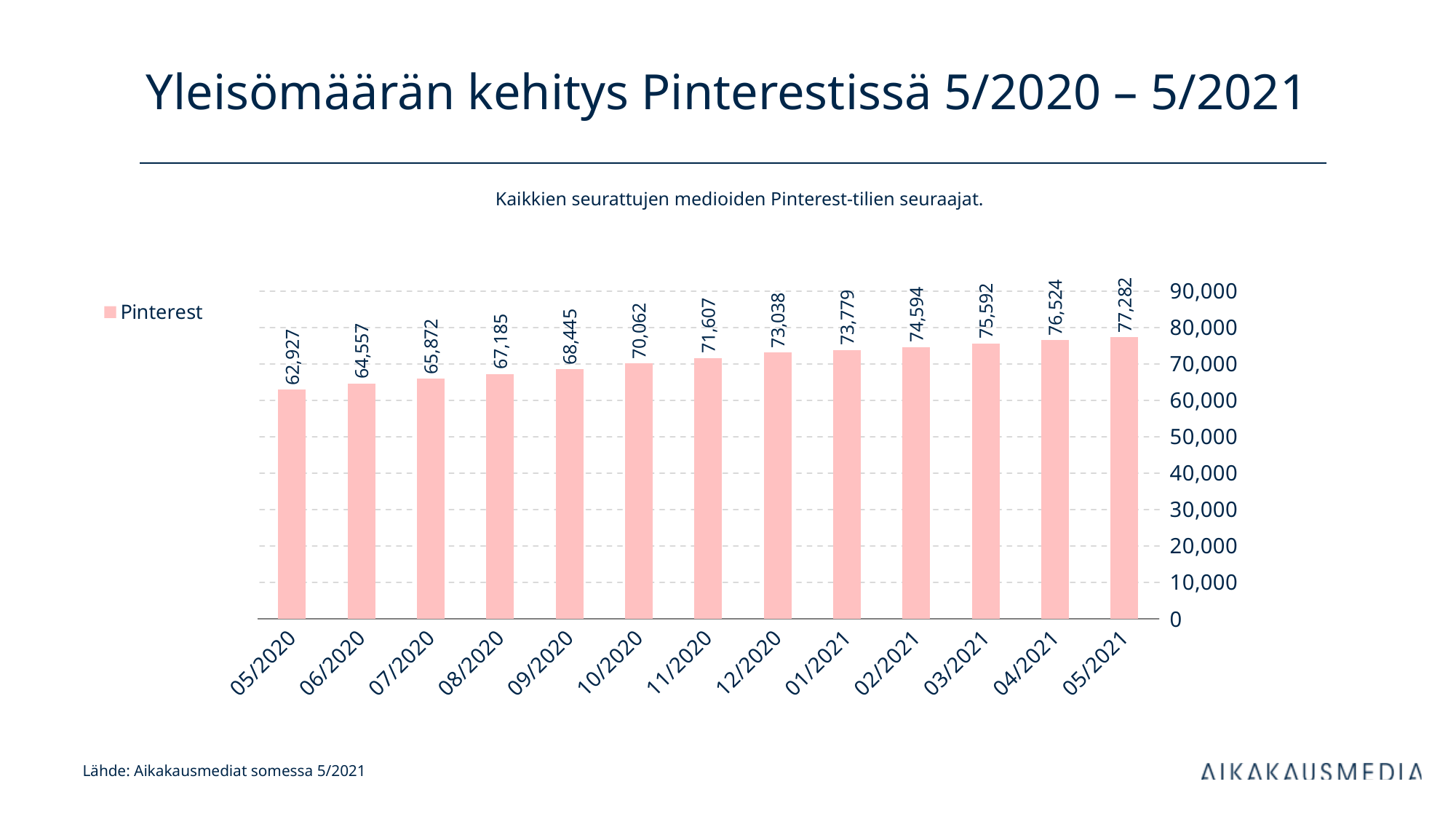
Which is larger, the value for 10/2020 or the value for 08/2020? 10/2020 Is the value for 09/2020 greater or less than 70,000? less How many series does the legend list? 1 Which month has the highest value? 05/2021 What is the value for 05/2020? 62,927 Which month has the lowest value? 05/2020 Do the values rise or fall from 05/2020 to 05/2021? rise How many months are shown on the x axis? 13 What is the value for 12/2020? 73,038 What is the value for 05/2021? 77,282 What kind of chart is shown on the slide? bar chart What is the difference between the values for 05/2021 and 05/2020? 14,355